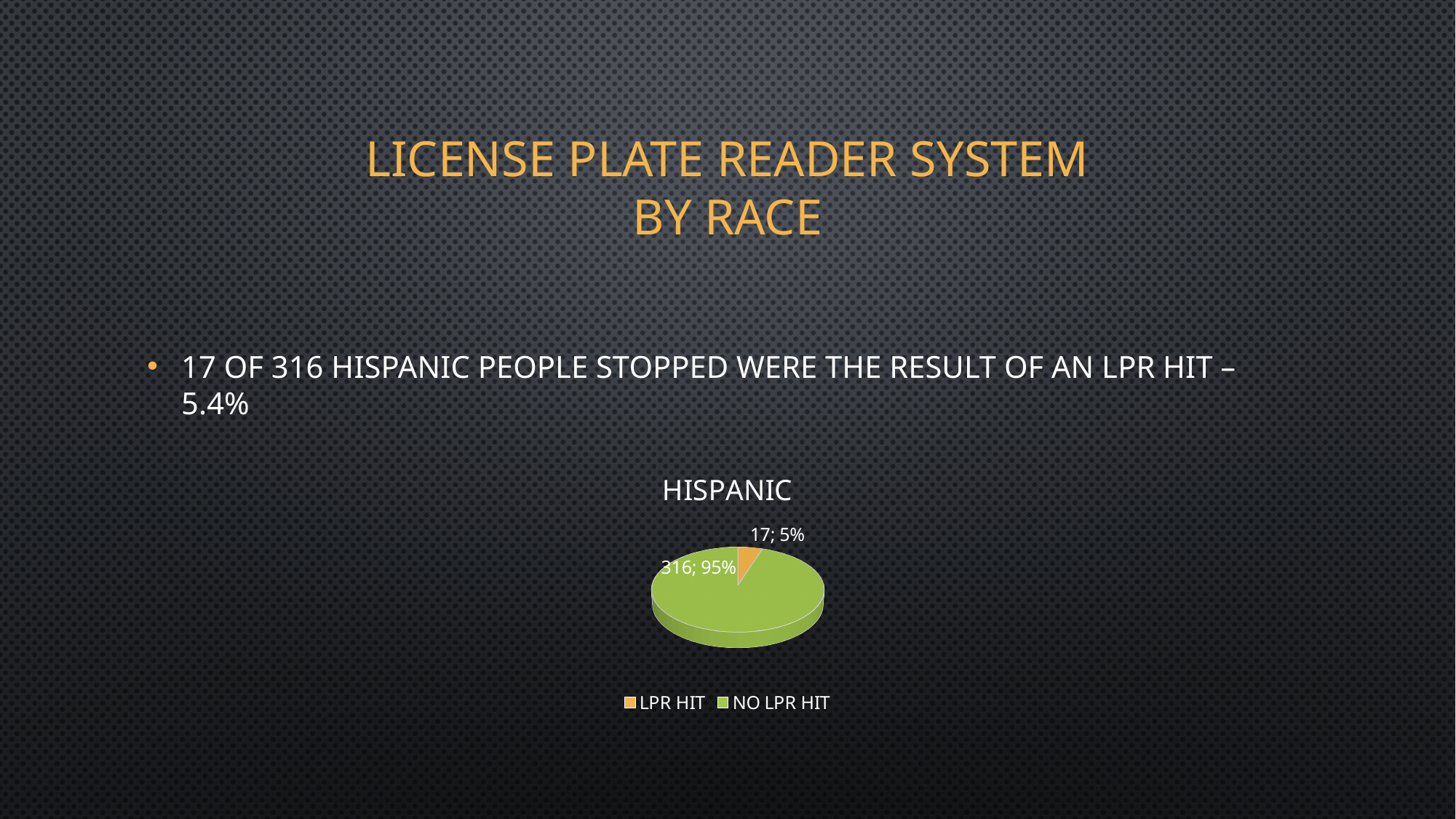
How many series does the legend list? 2 What is the value for NO LPR HIT? 316 What is the value for LPR HIT? 17 What share of the pie is LPR HIT? 5% What share of the pie is NO LPR HIT? 95% What is the difference between the NO LPR HIT value and the LPR HIT value? 299 What kind of chart is shown on the slide? Pie chart Which slice is the smallest? LPR HIT Which slice is the largest? NO LPR HIT Which is larger, LPR HIT or NO LPR HIT? NO LPR HIT What is the title of the chart? HISPANIC What colour is the LPR HIT slice? Orange